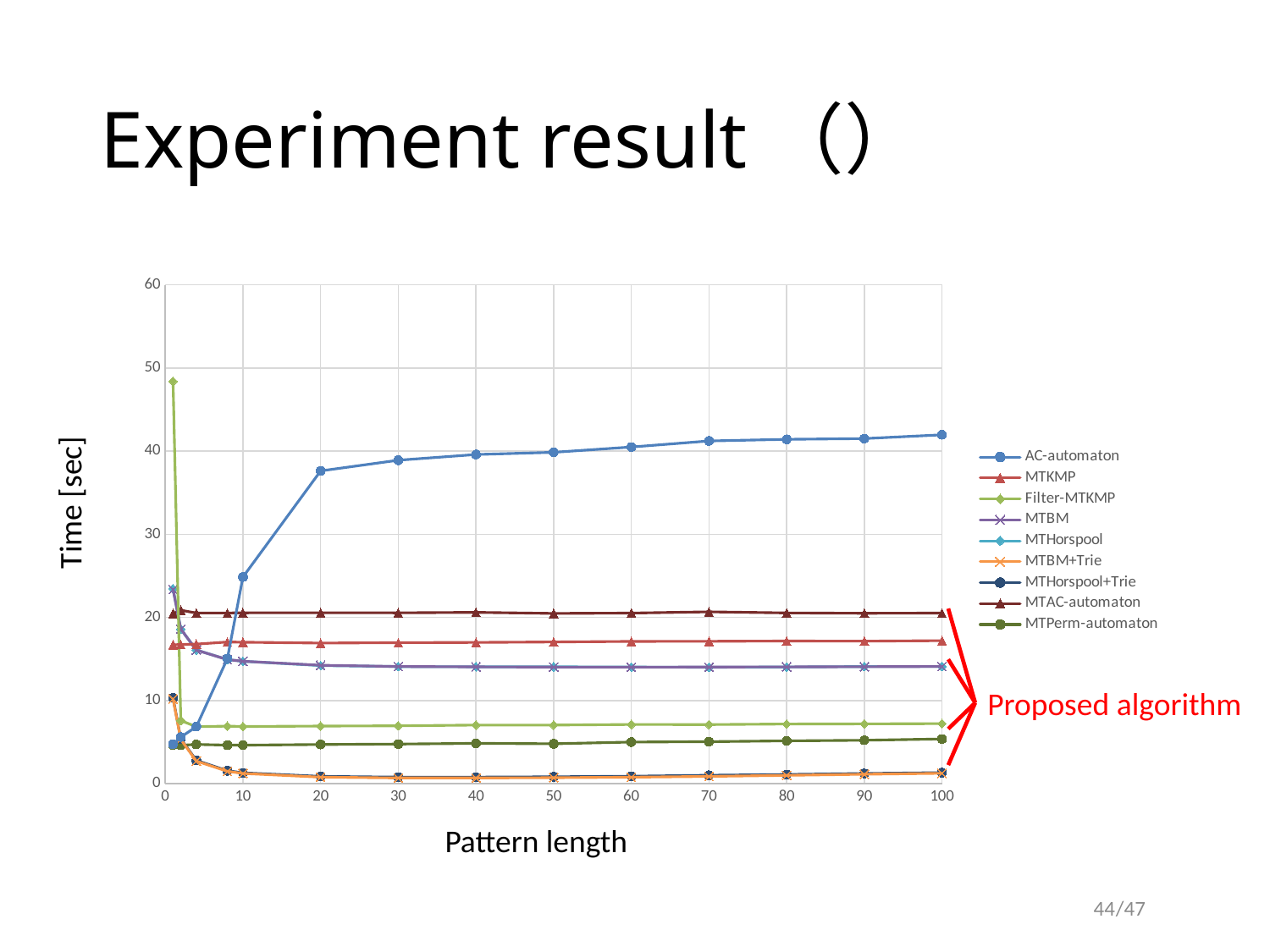
What kind of chart is shown on the slide? line chart What is the title of the y axis? Time [sec] How many series does the legend list? 9 What is the title of the x axis? Pattern length Is the value for AC-automaton at pattern length 100 greater or less than 40? greater Does the Filter-MTKMP series rise or fall as pattern length increases? fall Which series has the highest value at pattern length 100? AC-automaton Is the value for MTPerm-automaton at pattern length 100 greater or less than 10? less Is the value for MTKMP at pattern length 50 greater or less than 20? less Which series has the highest value at pattern length 1? Filter-MTKMP Does the AC-automaton series rise or fall as pattern length increases? rise At pattern length 100, which is larger: AC-automaton or MTKMP? AC-automaton